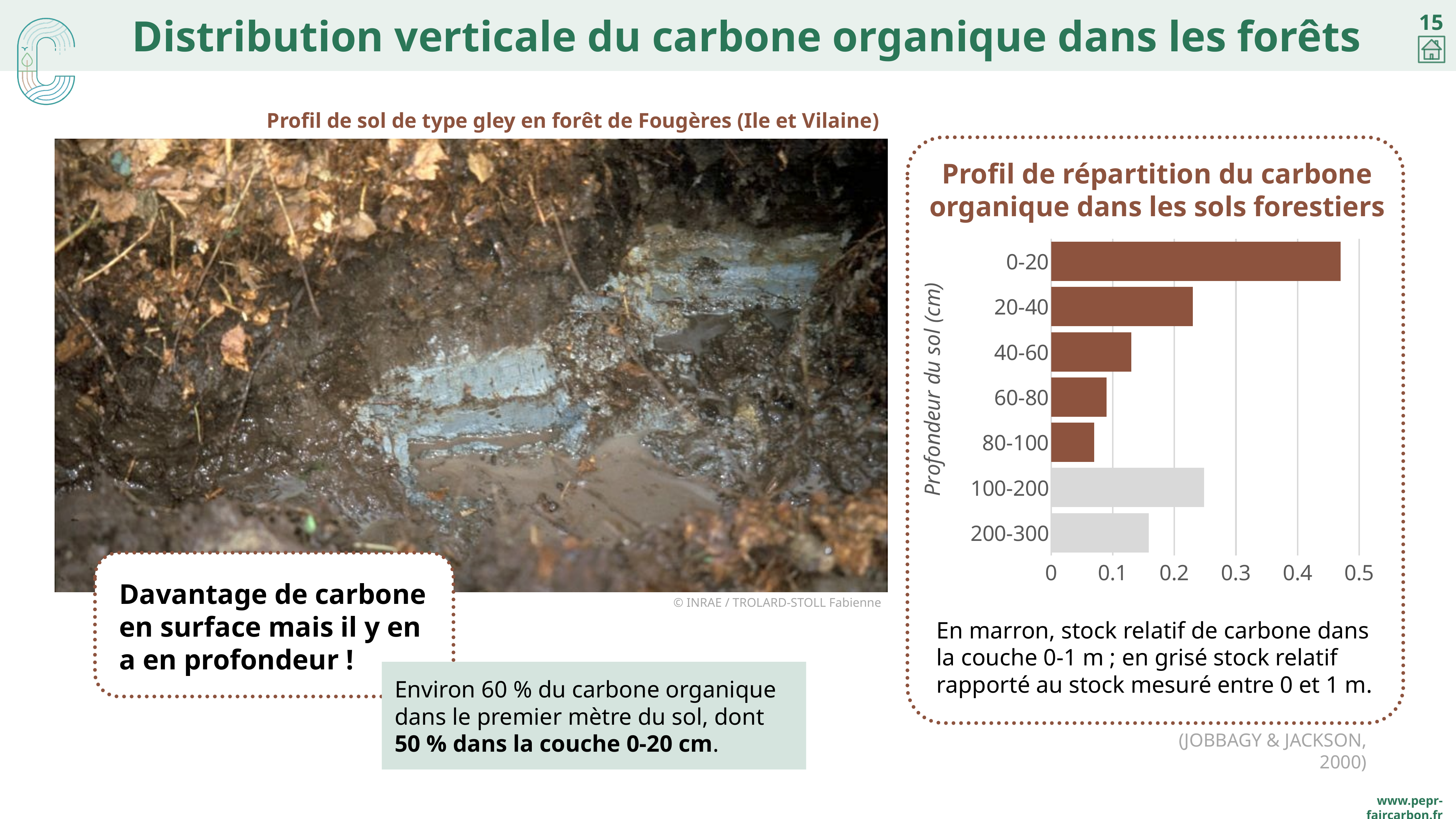
Is the value for the 20-40 depth category greater or less than 0.2? greater What kind of chart is shown in the 'Profil de répartition du carbone organique dans les sols forestiers' panel? bar chart Which depth category has the lowest value in the chart? 80-100 How many depth categories are plotted in the chart? 7 Is the value for the 80-100 depth category greater or less than 0.1? less Is the value for the 0-20 depth category greater or less than 0.4? greater Which depth category has the highest value in the chart? 0-20 Which has the larger value, the 0-20 category or the 20-40 category? 0-20 Do the values of the brown bars rise or fall as depth increases from 0-20 to 80-100? fall What is the label of the vertical axis of the chart? Profondeur du sol (cm)